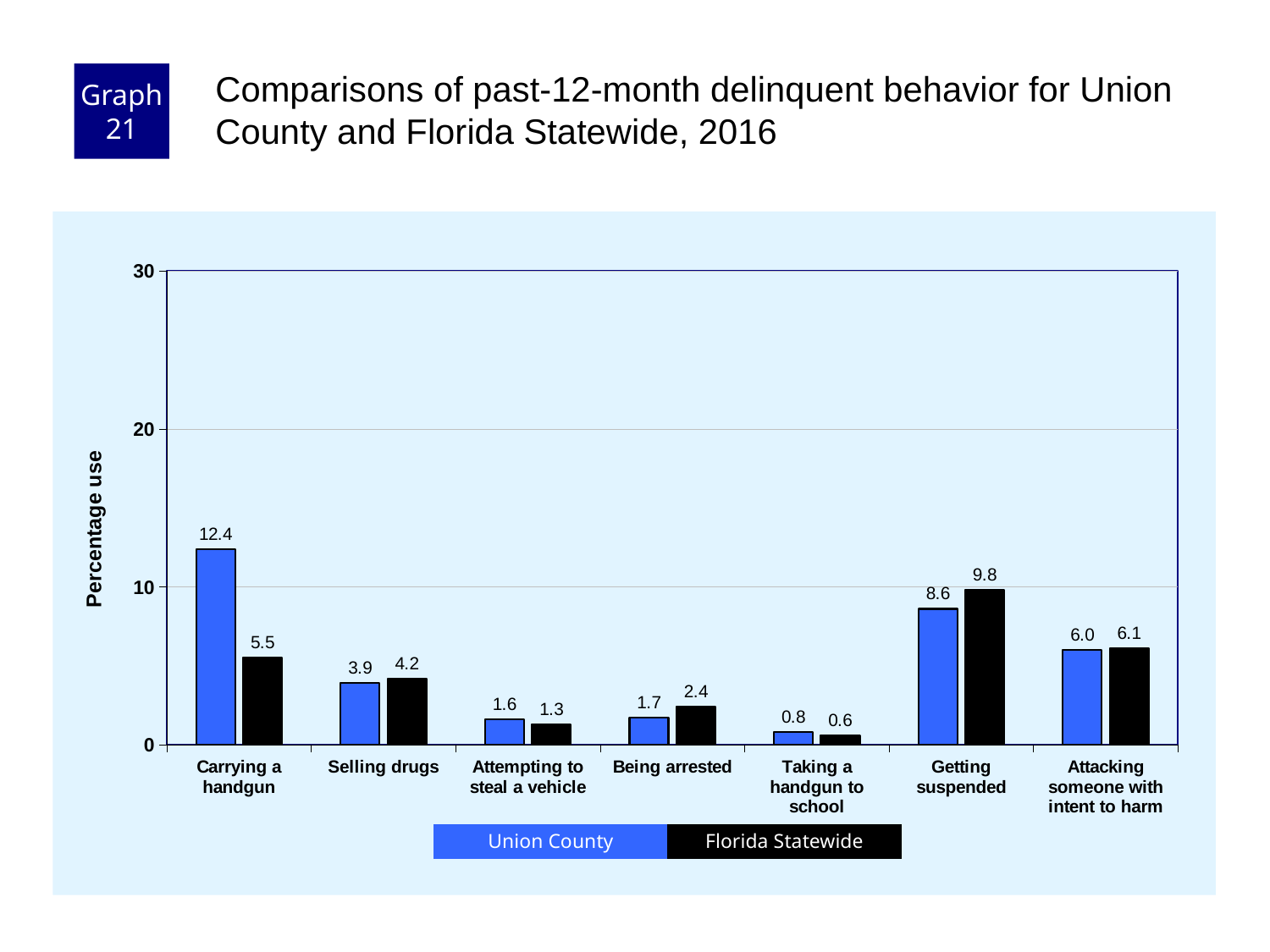
Which category has the highest Union County value? Carrying a handgun Which category has the lowest Florida Statewide value? Taking a handgun to school Which is larger for Being arrested, the Union County value or the Florida Statewide value? Florida Statewide What is the Florida Statewide value for Getting suspended? 9.8 What is the Union County value for Carrying a handgun? 12.4 How many behavior categories are shown on the x axis? 7 Is the Union County value for Carrying a handgun greater or less than 10? greater What is the label of the y axis? Percentage use What is the Union County value for Taking a handgun to school? 0.8 What kind of chart is shown on the slide? Bar chart What is the difference between the Union County and Florida Statewide values for Carrying a handgun? 6.9 How many series does the legend list? 2